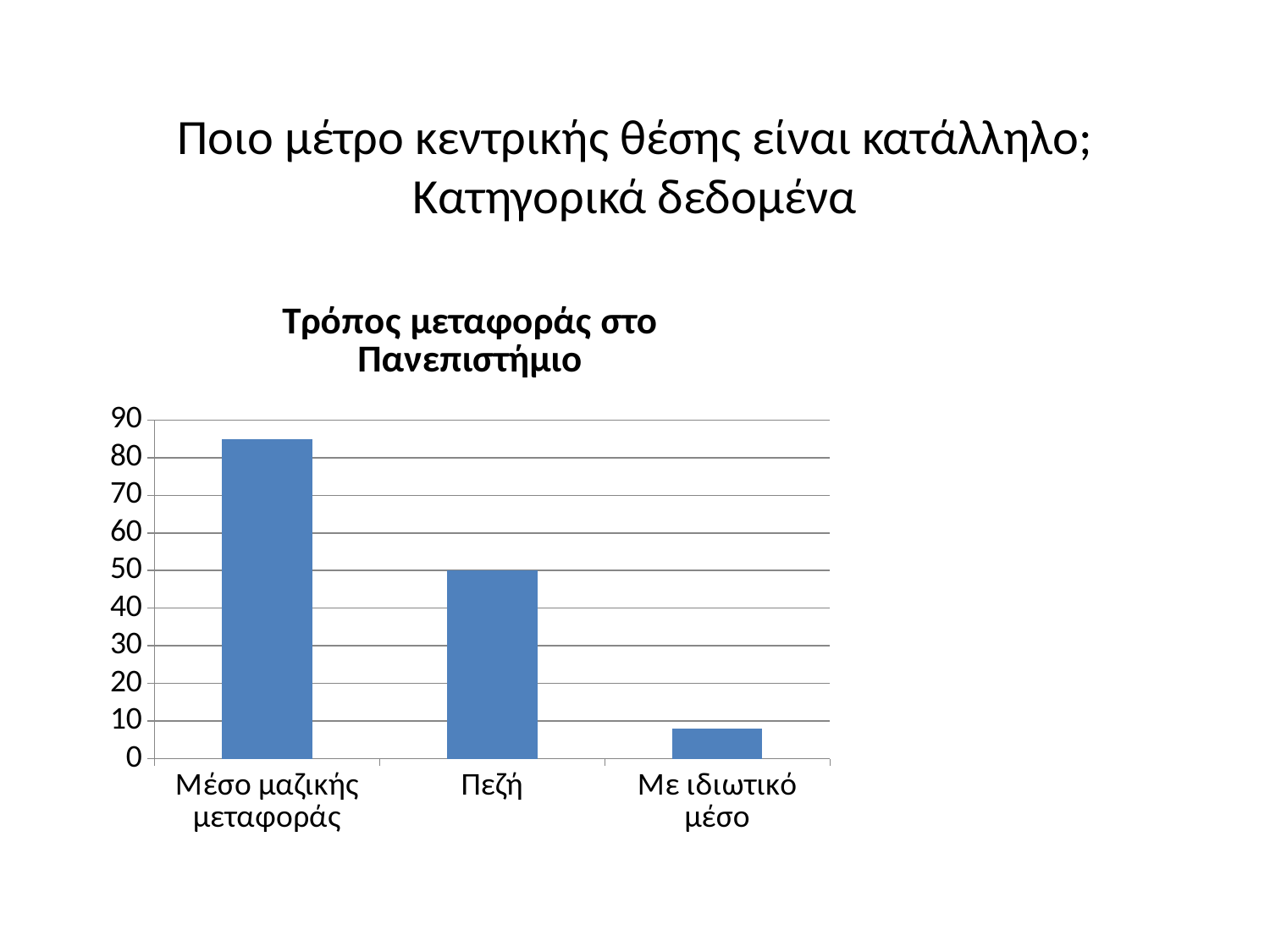
What is the title of the chart? Τρόπος μεταφοράς στο Πανεπιστήμιο What kind of chart is shown on the slide? bar chart What is the value for Πεζή? 50 How many categories are shown on the x axis of the chart? 3 Is the value for Με ιδιωτικό μέσο greater or less than 10? less Do the bar values rise or fall from left to right along the x axis? fall Which category has the highest bar? Μέσο μαζικής μεταφοράς Is the value for Μέσο μαζικής μεταφοράς greater or less than 80? greater Which is larger, the value for Πεζή or the value for Με ιδιωτικό μέσο? Πεζή Which category has the lowest bar? Με ιδιωτικό μέσο What is the highest value shown on the vertical axis? 90 Is the value for Μέσο μαζικής μεταφοράς greater or less than 90? less